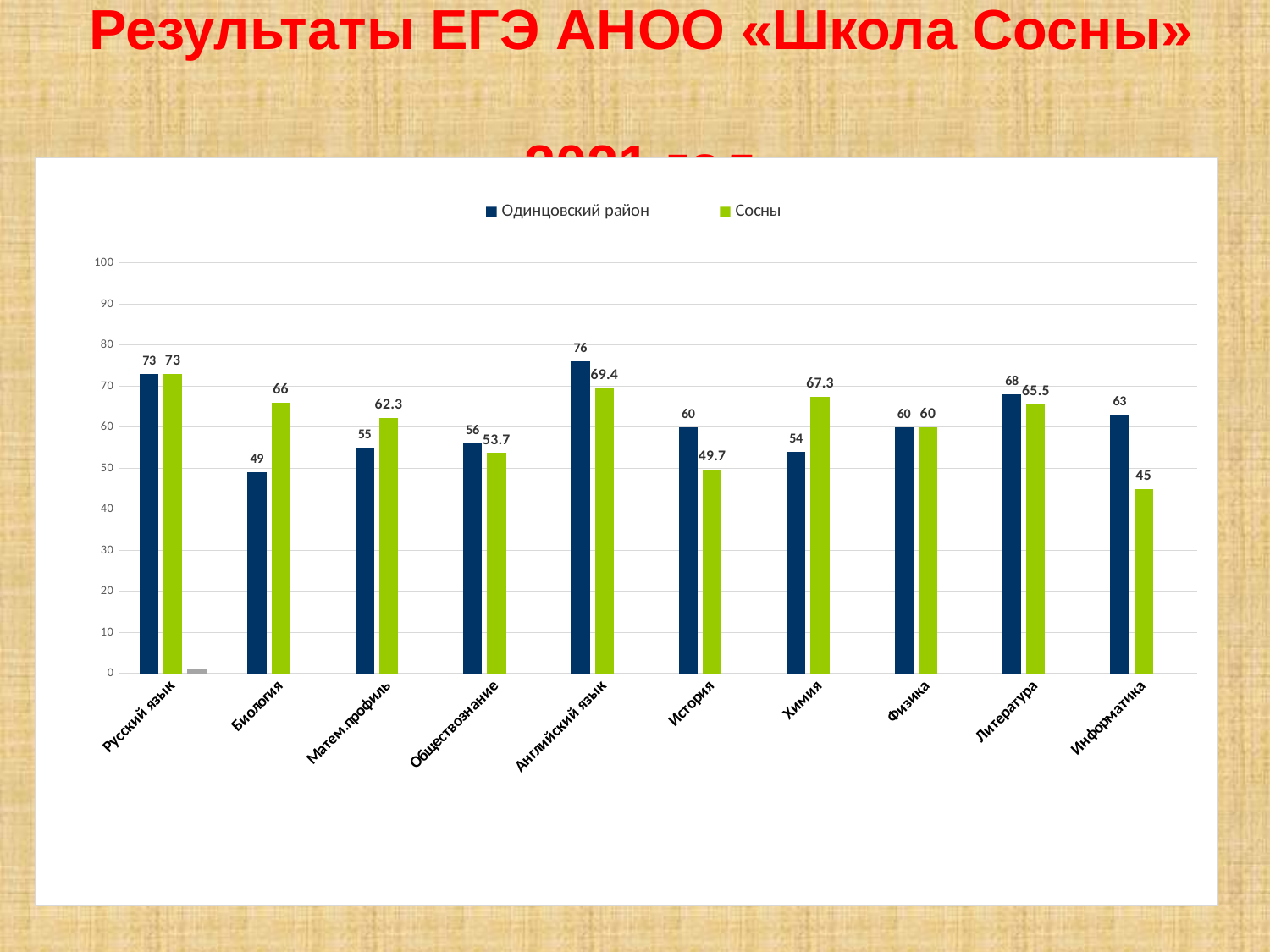
What kind of chart is shown on the slide? Bar chart What is the value for Сосны in Биология? 66 What is the value for Одинцовский район in Английский язык? 76 How many subjects are shown on the x axis? 10 What is the value for Одинцовский район in Информатика? 63 What is the difference between the Одинцовский район and Сосны values in Информатика? 18 What is the difference between the Сосны and Одинцовский район values in Биология? 17 Which subject has the highest value for Одинцовский район? Английский язык What is the value for Сосны in Химия? 67.3 How many series does the legend list? 2 In История, which series has the larger value, Одинцовский район or Сосны? Одинцовский район Which subject has the lowest value for Сосны? Информатика